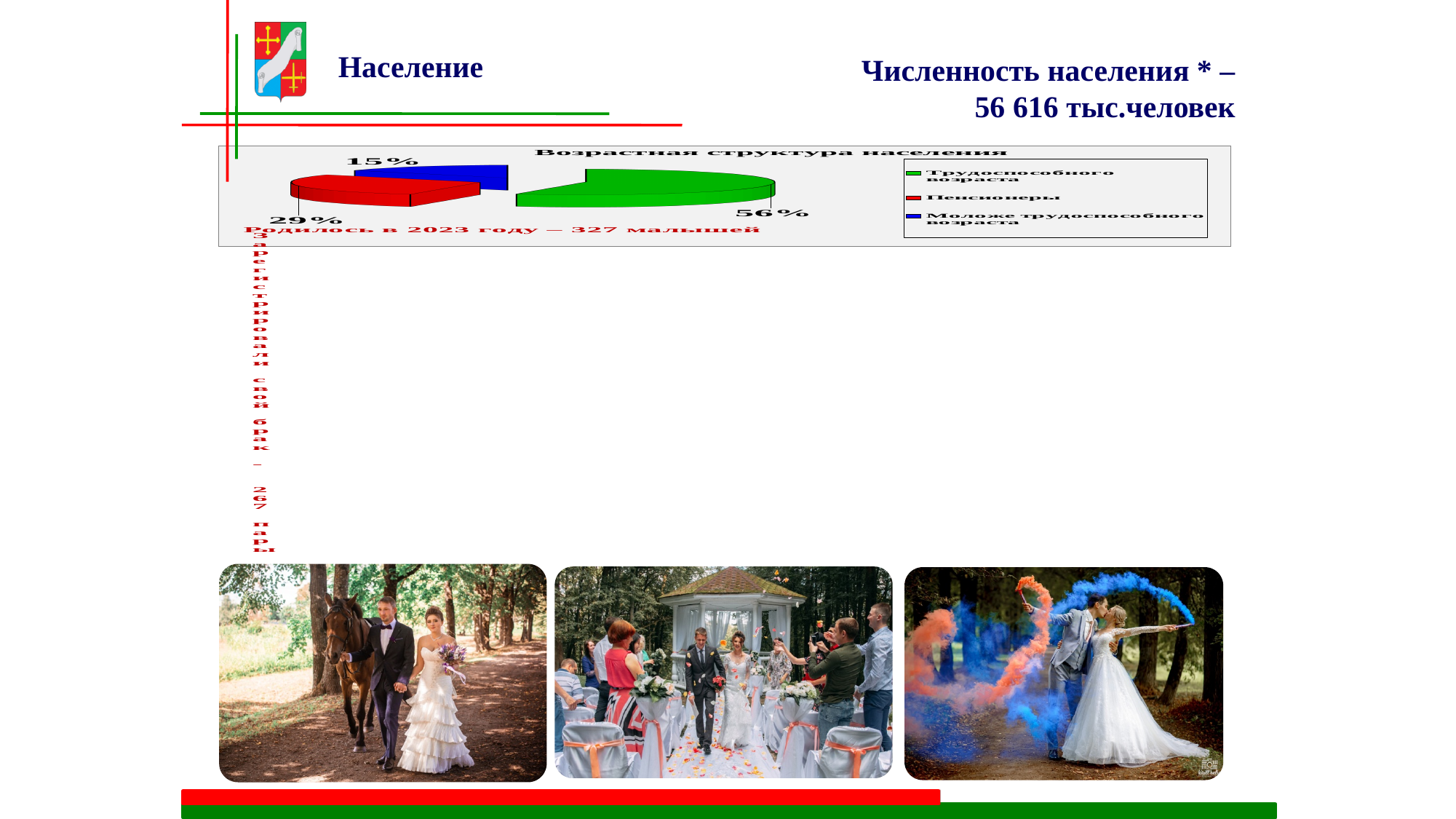
What share of the population is younger than working age (Моложе трудоспособного возраста)? 15% Which is larger: the share of pensioners or the share of those younger than working age? Пенсионеры What share of the population are pensioners (Пенсионеры)? 29% What share of the population is of working age (Трудоспособного возраста)? 56% How many entries does the legend list? 3 Which category has the smallest share of the pie? Моложе трудоспособного возраста What is the difference in percentage points between the working-age share and the pensioners share? 27 Which category has the largest share of the pie? Трудоспособного возраста What kind of chart is shown on the slide? pie chart How many slices does the pie chart have? 3 What colour is the slice for Пенсионеры? red What is the title of the chart on the slide? Возрастная структура населения